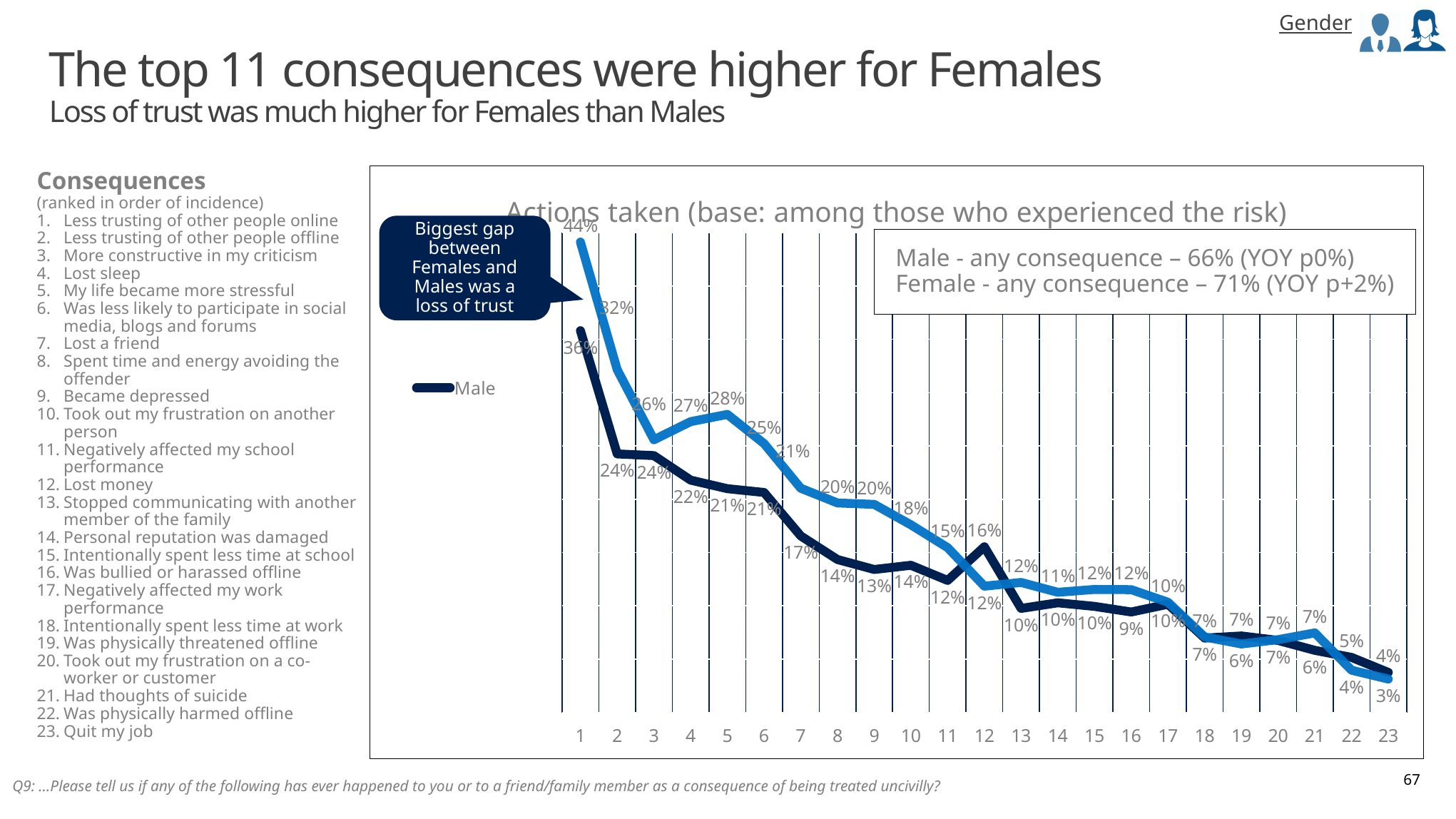
At which category is the Female line at its highest value? 1 What is the Male value for category 12? 16% At category 12, which series has the larger value, Male or Female? Male How many categories are plotted along the x axis of the chart? 23 Overall, do the values rise or fall as you move from category 1 to category 23? fall What is the difference between the Female and Male values at category 1? 8 percentage points What is the Female value for category 1 in the chart? 44% What is the title of the chart? Actions taken (base: among those who experienced the risk) What is the Male value for category 23? 4% What is the Female value for category 5? 28% What is the Male value for category 1 in the chart? 36% What kind of chart is shown on the slide? line chart